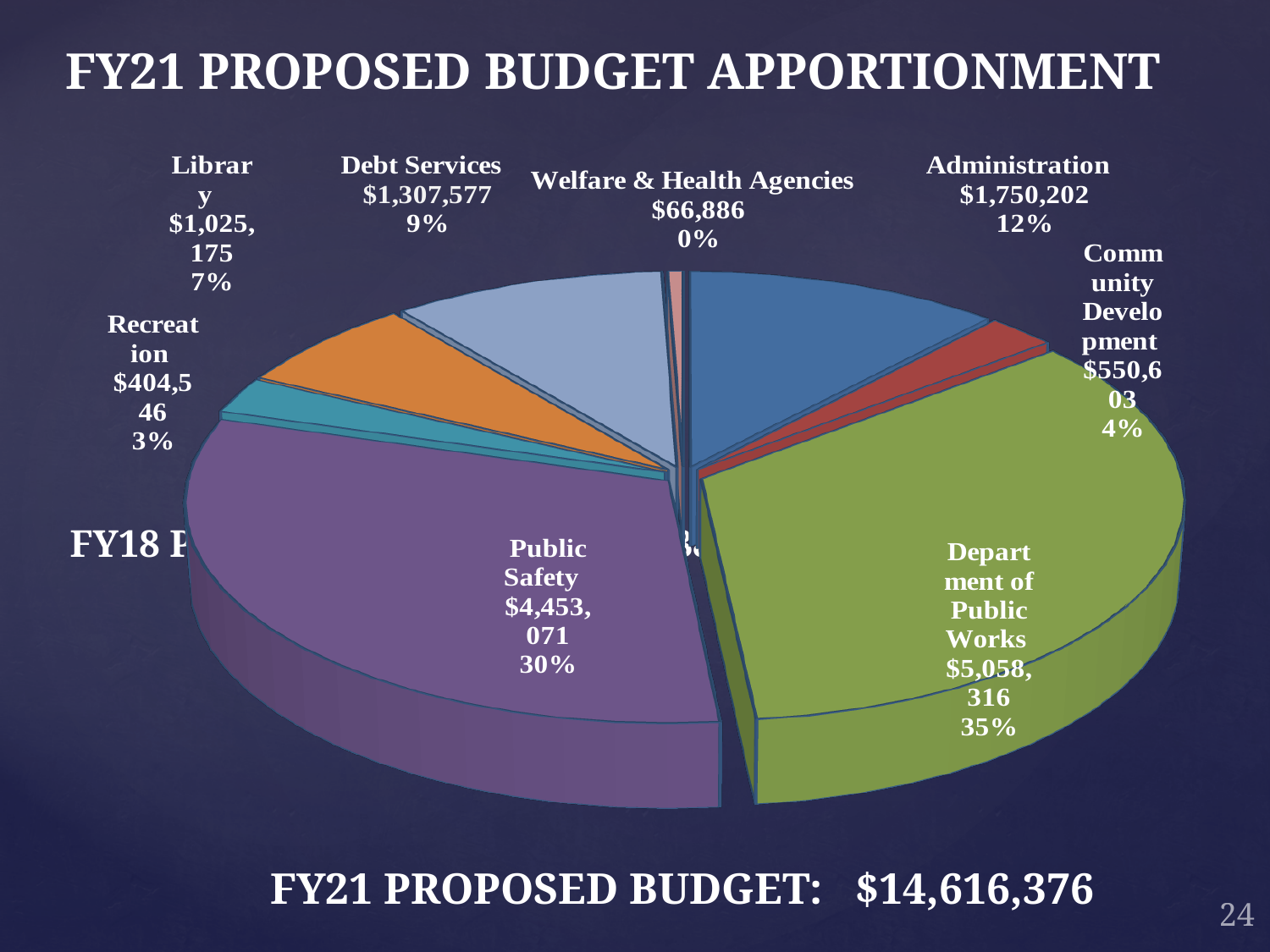
Which category has the largest slice of the pie chart? Department of Public Works Which is larger, the Library slice or the Debt Services slice? Debt Services What share of the budget does Community Development receive? 4% How many categories are shown in the pie chart? 8 What percentage of the FY21 proposed budget goes to Public Safety? 30% What is the FY21 proposed budget total shown on the slide? $14,616,376 What is the value shown for Administration in the pie chart? $1,750,202 What is the value shown for Recreation? $404,546 What is the value shown for Debt Services? $1,307,577 Which category has the smallest slice of the pie chart? Welfare & Health Agencies What is the difference between the Department of Public Works value and the Public Safety value? $605,245 What kind of chart is shown on the slide? Pie chart